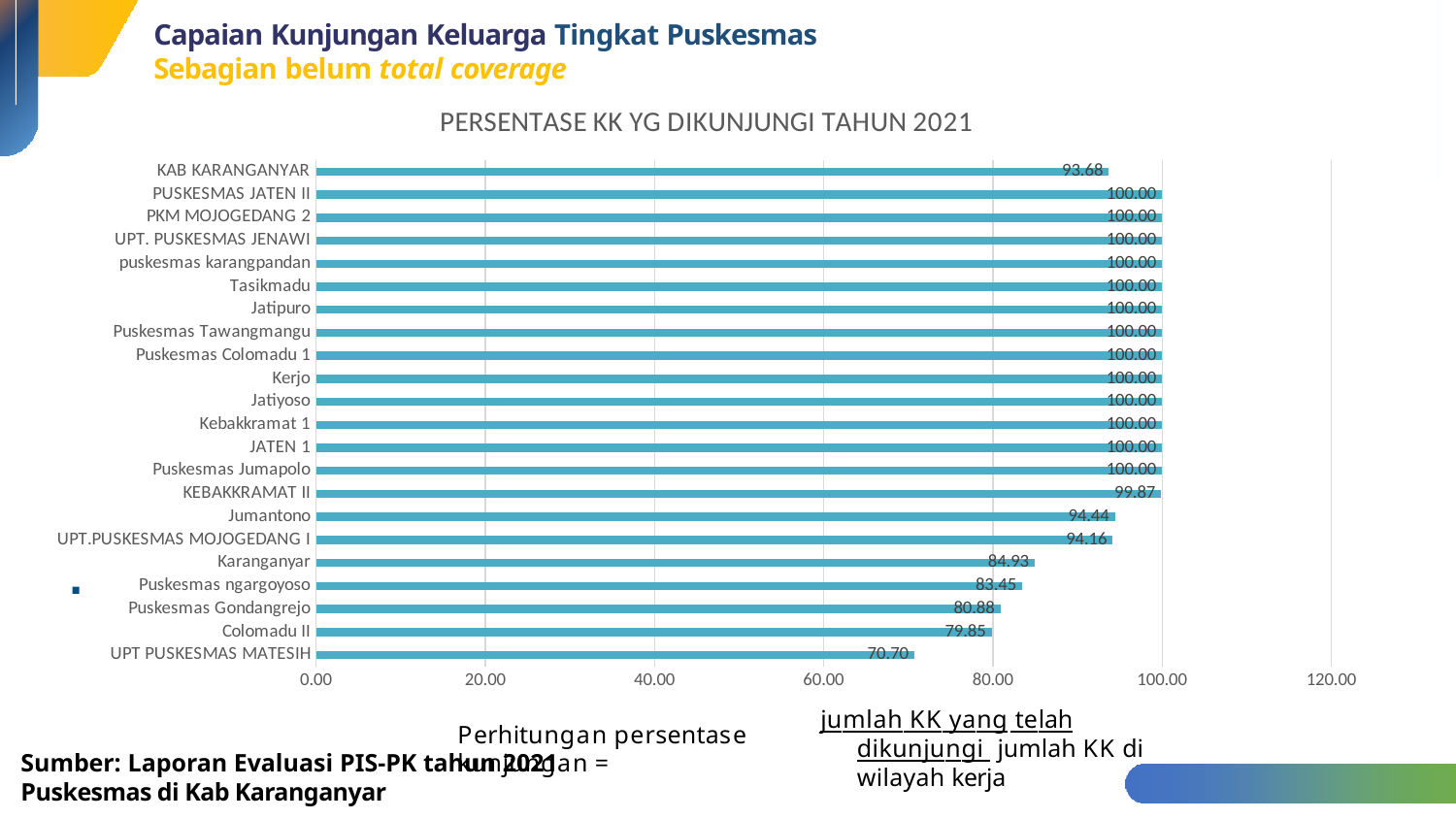
What is the title of the chart? PERSENTASE KK YG DIKUNJUNGI TAHUN 2021 What is the value for Puskesmas Gondangrejo? 80.88 How many categories are shown in the chart? 22 Which category has the lowest value? UPT PUSKESMAS MATESIH What is the value for KEBAKKRAMAT II? 99.87 What is the difference between the values for Karanganyar and Colomadu II? 5.08 What is the value for UPT PUSKESMAS MATESIH? 70.70 Is the value for UPT PUSKESMAS MATESIH greater or less than 80.00? less What kind of chart is shown on the slide? bar chart What is the difference between the values for Jumantono and UPT.PUSKESMAS MOJOGEDANG I? 0.28 What is the value for KAB KARANGANYAR? 93.68 Which is larger, the value for Puskesmas ngargoyoso or the value for Colomadu II? Puskesmas ngargoyoso